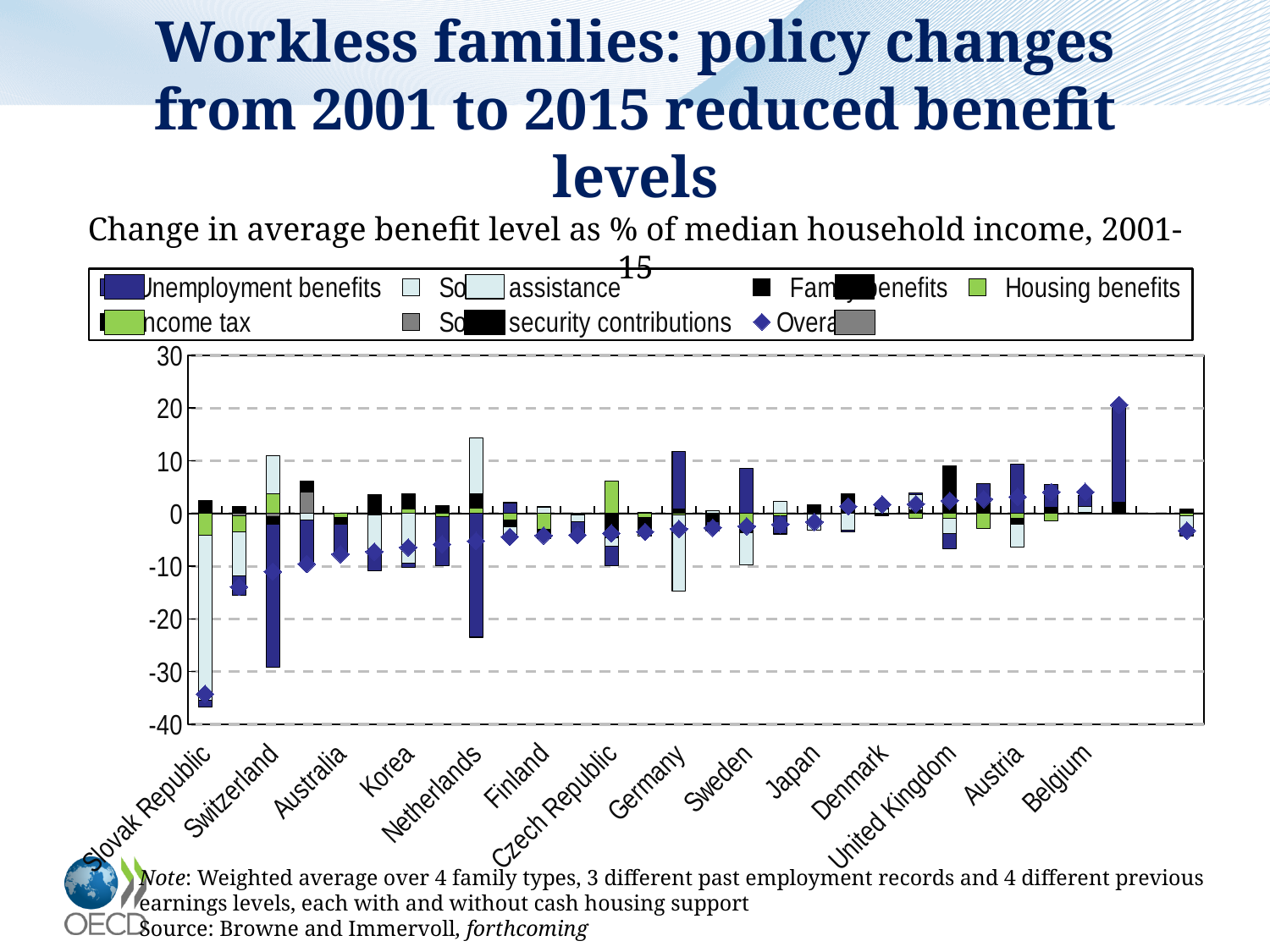
What is the subtitle describing what the chart plots? Change in average benefit level as % of median household income, 2001-15 How many series does the legend list? 7 Which country has the lowest Overall value? Slovak Republic What kind of chart is shown on the slide? bar chart Is the Overall value for the Slovak Republic greater or less than -30? less Is the Overall value for the Slovak Republic greater or less than 0? less What marker shape is used for the Overall series in the legend? diamond Do the Overall values generally rise or fall moving from left to right along the x axis? rise